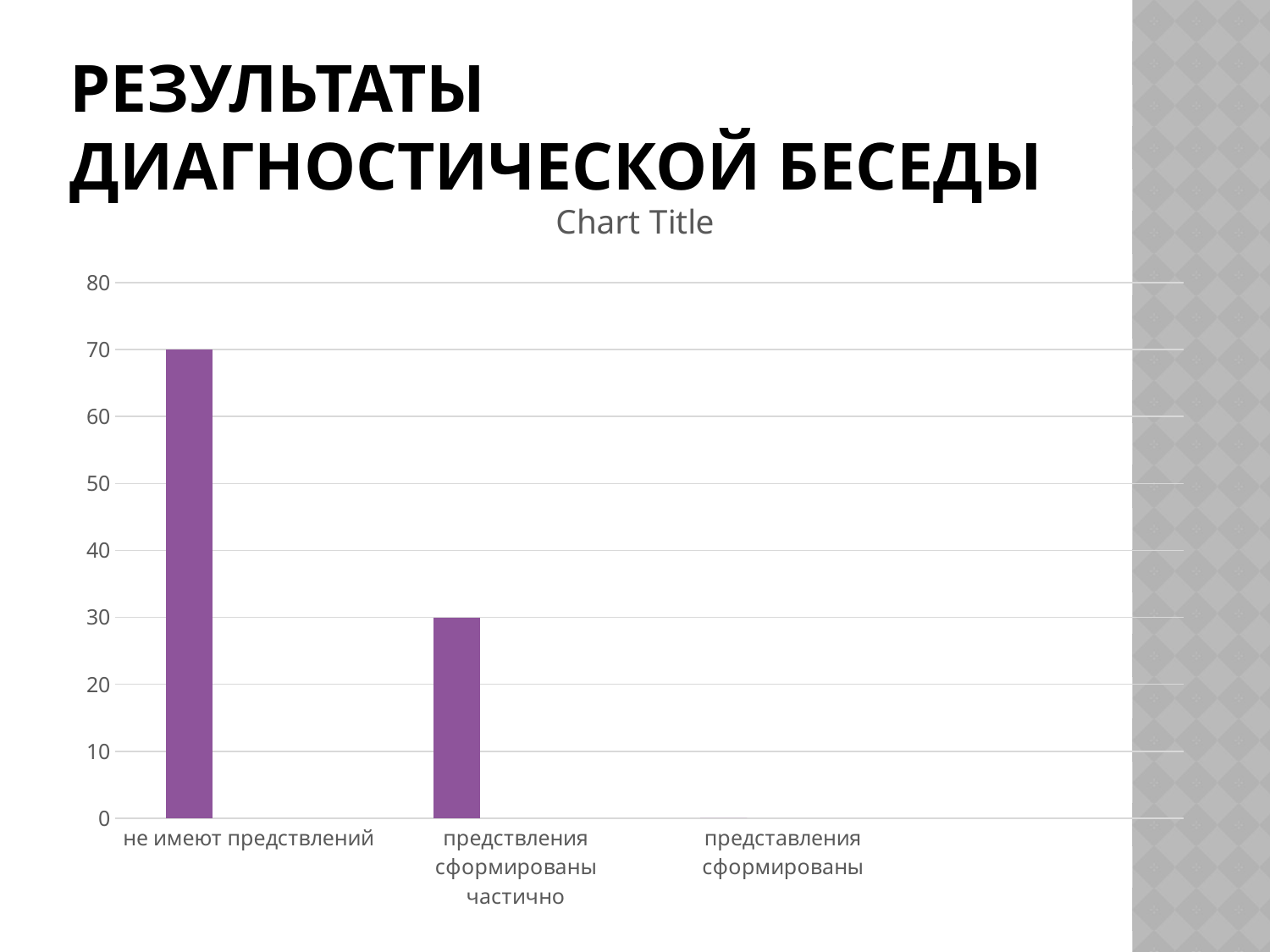
How many categories are shown on the x axis? 3 Which is larger: the value for "не имеют представлений" or for "представления сформированы частично"? не имеют предствлений What is the difference between the values for "не имеют представлений" and "представления сформированы частично"? 40 What kind of chart is shown on the slide? bar chart What is the title shown above the chart? Chart Title Which category has the highest value? не имеют предствлений What is the value for "представления сформированы частично"? 30 What is the highest value labelled on the vertical axis? 80 Is the value for "представления сформированы частично" greater or less than 40? less Do the bar values rise or fall from left to right along the x axis? fall What is the value for "не имеют представлений"? 70 Is the value for "не имеют представлений" greater or less than 50? greater